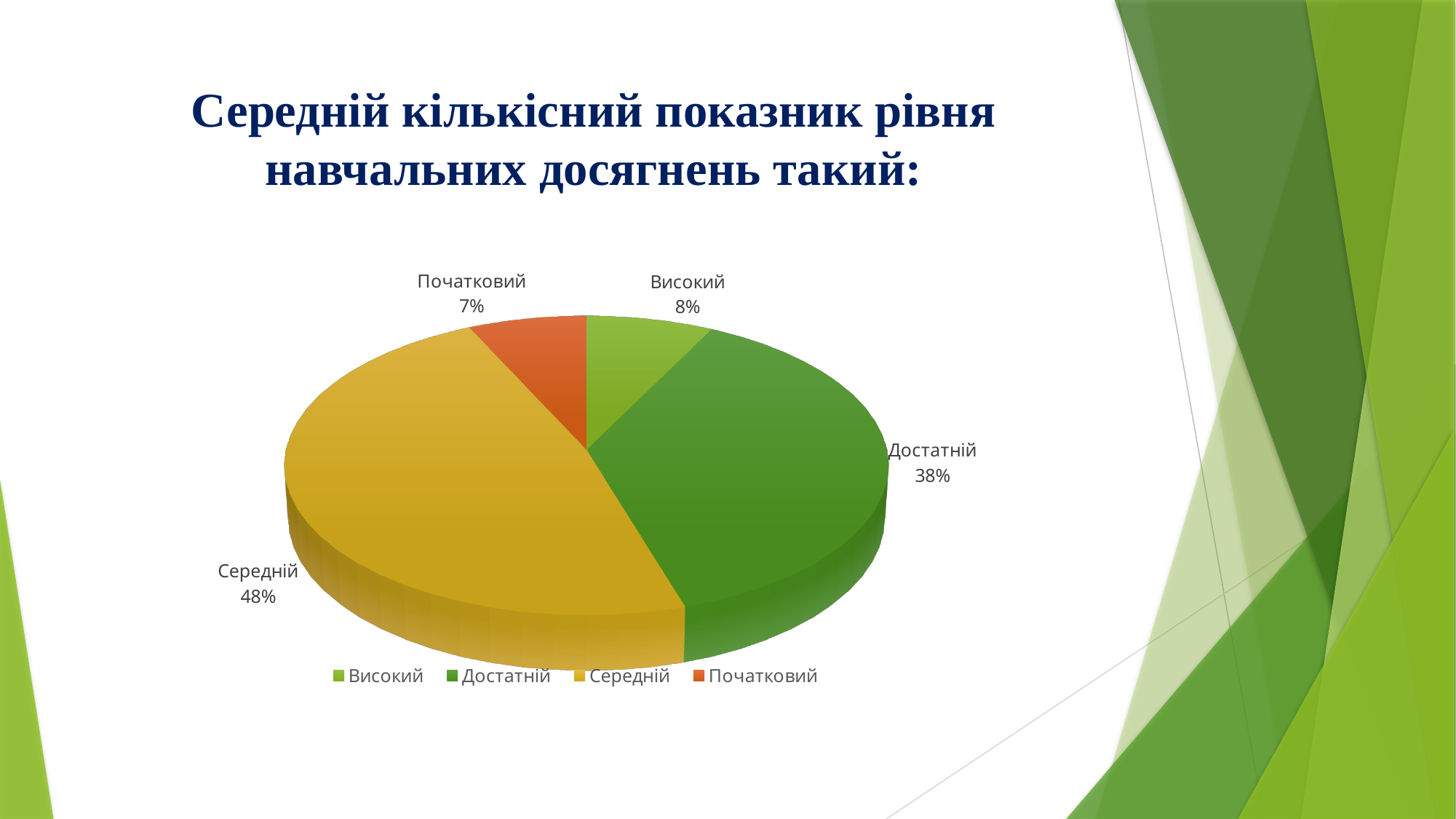
Which is larger, the share for Достатній or the share for Високий? Достатній What kind of chart is shown on the slide? Pie chart How many entries does the legend list? 4 Which category has the smallest slice of the pie? Початковий What share of the pie does Достатній have? 38% What colour is the Середній slice? Yellow Which category has the largest slice of the pie? Середній What share of the pie does Середній have? 48% What is the difference between the shares of Середній and Достатній? 10% What is the value shown for Високий? 8% How many categories are shown in the pie chart? 4 What is the value shown for Початковий? 7%